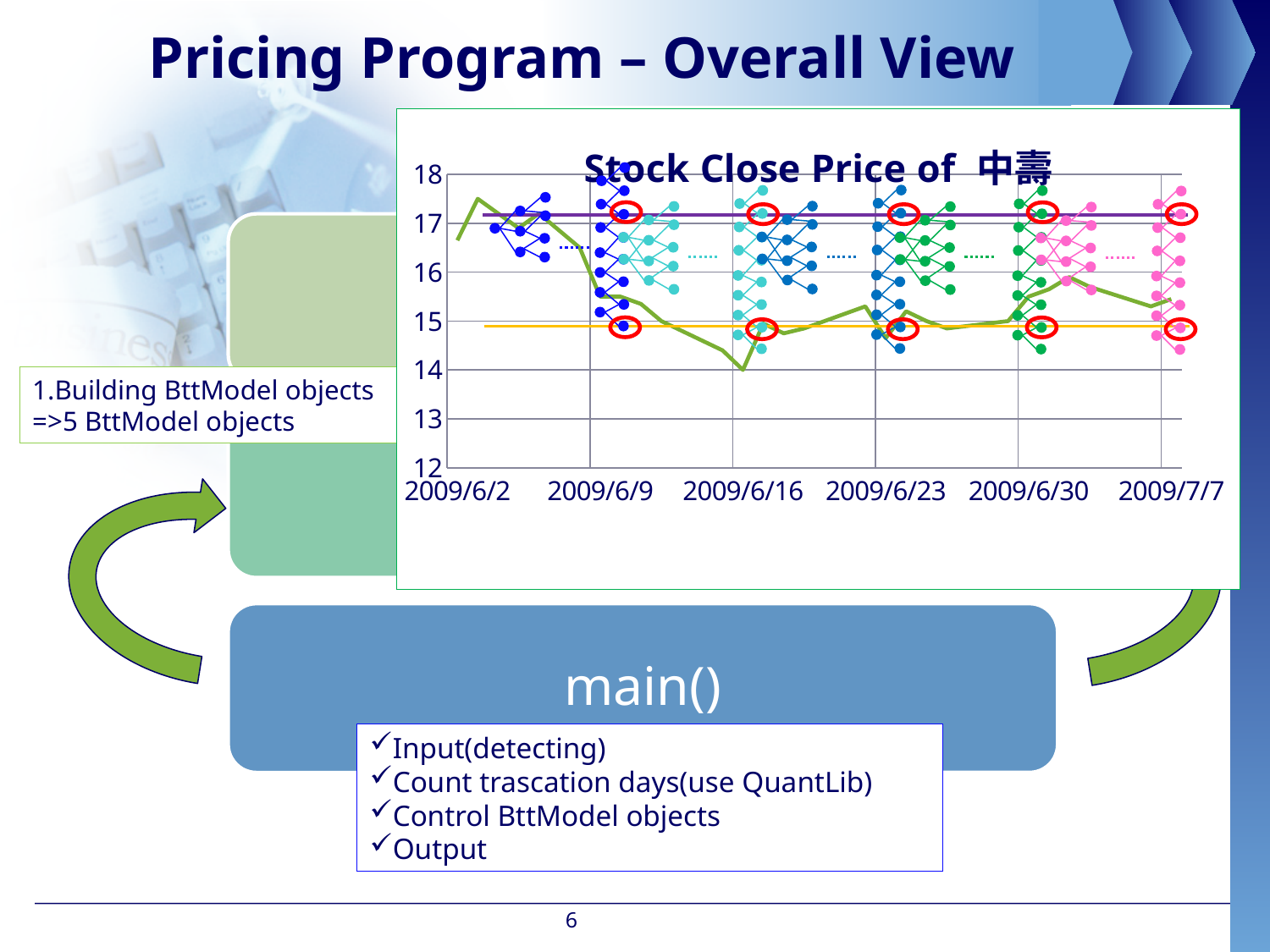
Is the close price at 2009/6/2 higher or lower than at 2009/7/7? higher What kind of chart is shown on the slide? line chart Is the stock close price at 2009/6/23 greater or less than 16? less Is the stock close price at 2009/7/7 greater or less than 16? less What is the lowest value shown on the y axis of the chart? 12 At which labelled date does the close price line reach its lowest point? 2009/6/16 How many date labels are shown on the x axis of the chart? 6 Does the stock close price overall rise or fall from 2009/6/2 to 2009/7/7? fall Is the stock close price at 2009/6/16 greater or less than 15? less What is the title of the chart? Stock Close Price of 中壽 What is the first date label on the x axis of the chart? 2009/6/2